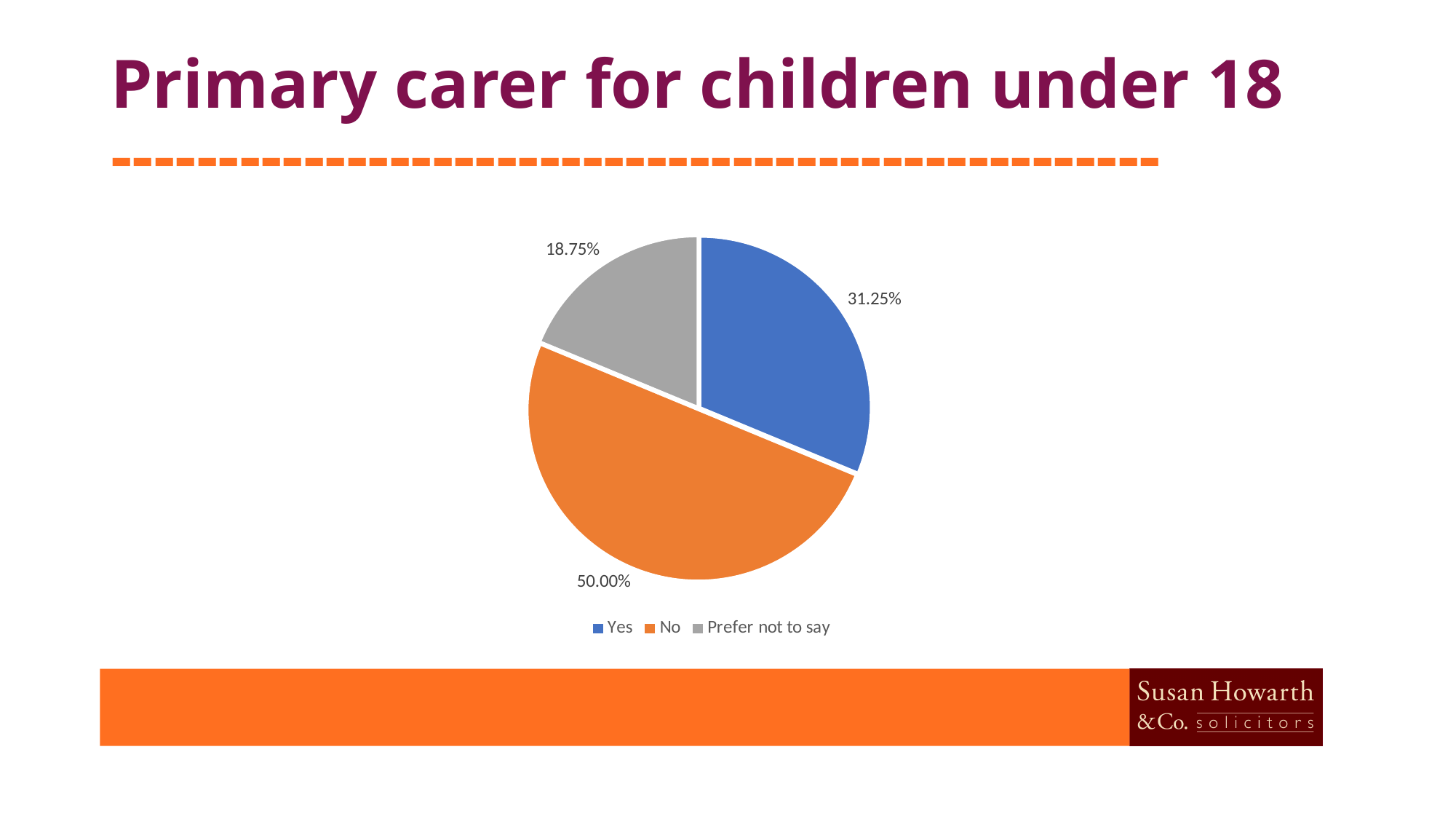
What percentage of respondents answered Yes? 31.25% What is the title of the slide? Primary carer for children under 18 Which category has the largest share of the pie? No What is the difference in percentage points between the No and Yes slices? 18.75% What colour is the No slice? Orange Which category has the smallest share of the pie? Prefer not to say What percentage of respondents answered No? 50.00% What percentage of respondents chose Prefer not to say? 18.75% How many categories are shown in the pie chart? 3 What kind of chart is shown on the slide? Pie chart What is the difference in percentage points between the Yes and Prefer not to say slices? 12.50% Which is larger, the Yes slice or the Prefer not to say slice? Yes